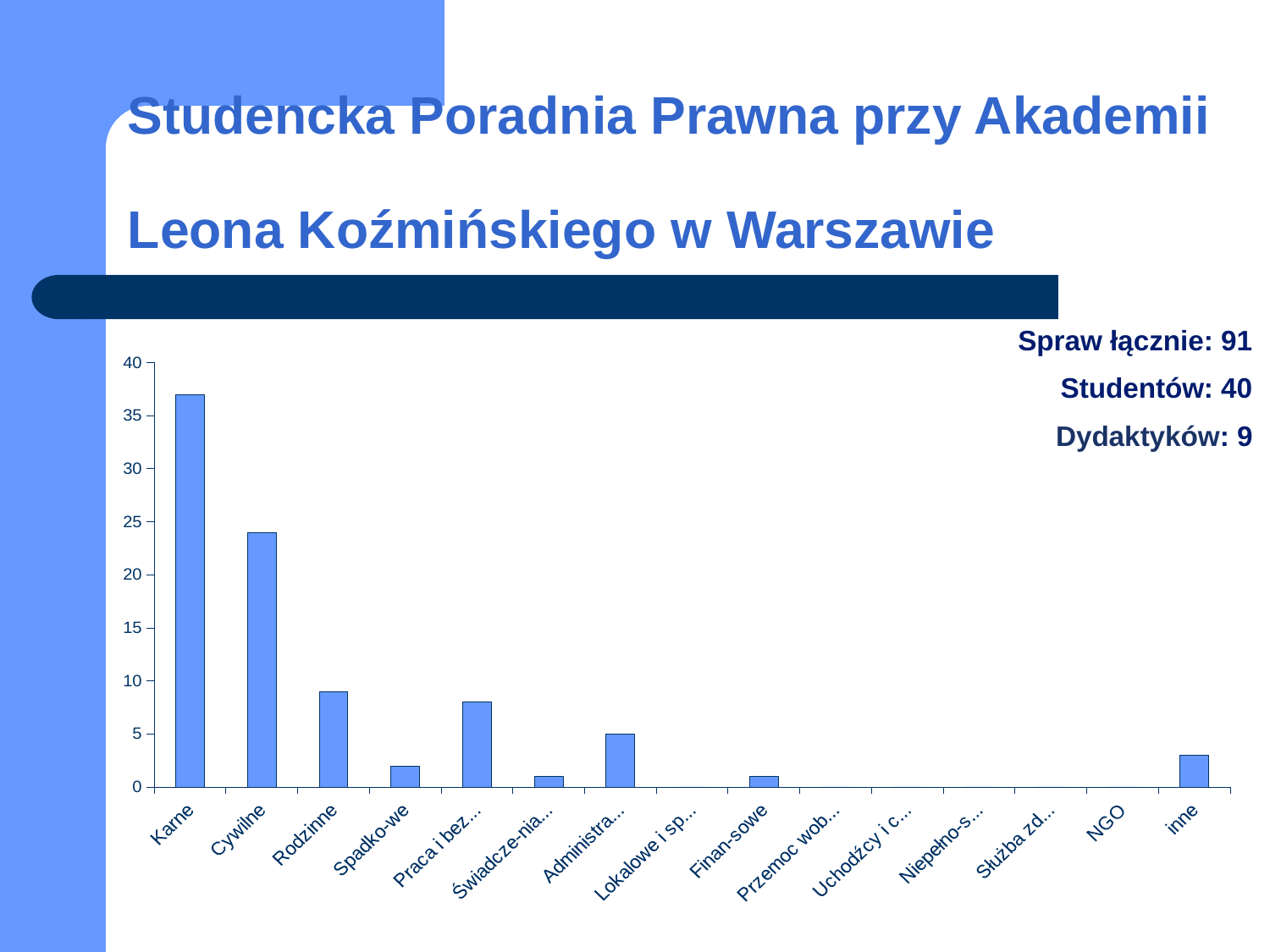
Is the value for Cywilne greater or less than 20? greater Is the value for inne greater or less than 5? less Which category has the highest bar in the chart? Karne What kind of chart is shown on the slide? bar chart Which is larger, the value for Karne or the value for Cywilne? Karne How many categories are shown on the x axis of the chart? 15 What is the highest value shown on the vertical axis of the chart? 40 Is the value for Spadko-we greater or less than 5? less Which is larger, the value for Rodzinne or the value for Spadko-we? Rodzinne